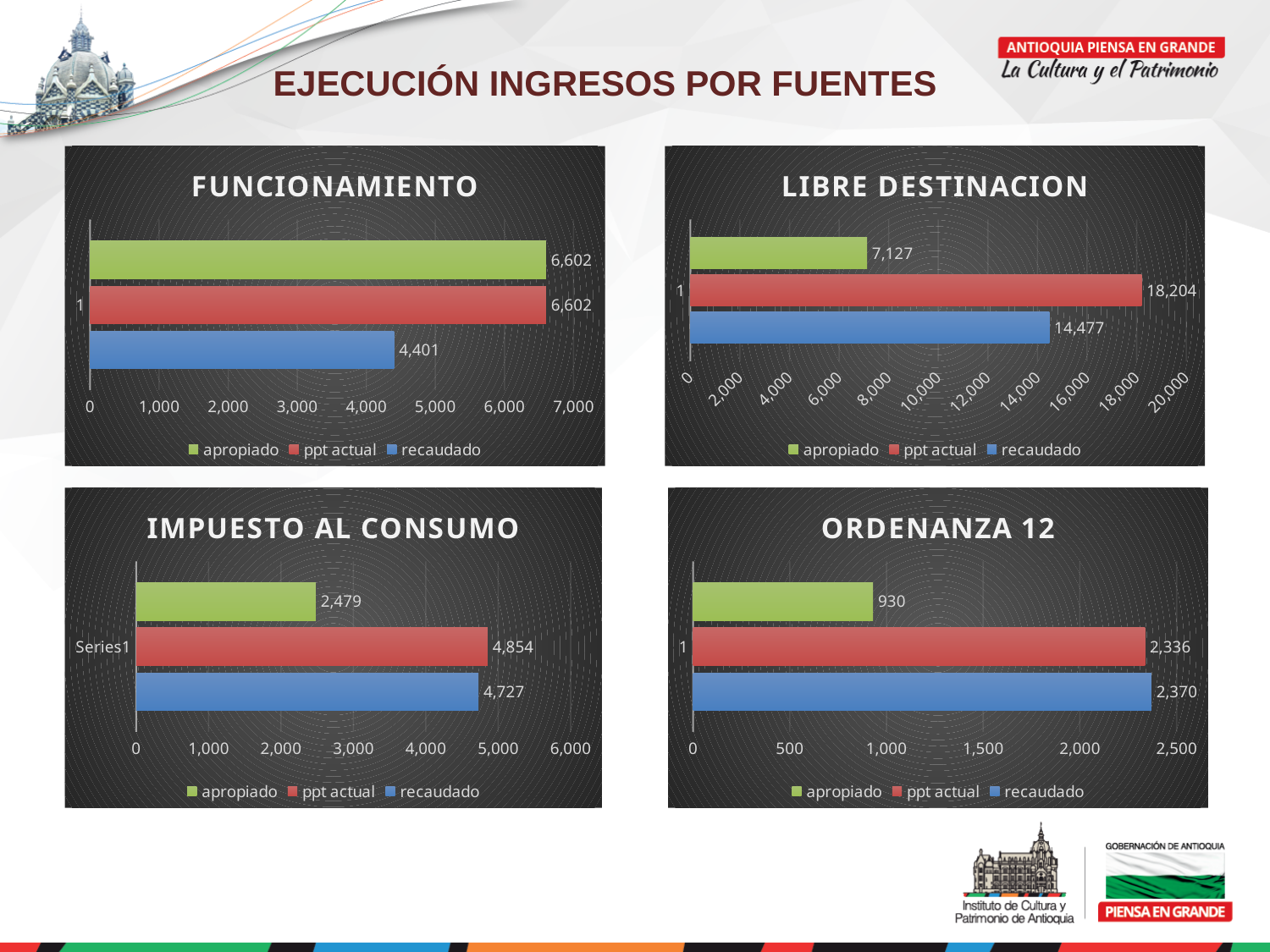
In the IMPUESTO AL CONSUMO chart, which series has the highest value? ppt actual In the ORDENANZA 12 chart, is the value for apropiado greater or less than 1,000? less In the LIBRE DESTINACION chart, which series has the lowest value? apropiado How many series does the legend of the ORDENANZA 12 chart list? 3 In the FUNCIONAMIENTO chart, what is the value for apropiado? 6,602 What kind of chart is the LIBRE DESTINACION chart? bar chart In the IMPUESTO AL CONSUMO chart, what is the value for apropiado? 2,479 In the ORDENANZA 12 chart, what is the value for recaudado? 2,370 In the FUNCIONAMIENTO chart, what is the difference between apropiado and recaudado? 2,201 In the FUNCIONAMIENTO chart, what is the value for recaudado? 4,401 In the LIBRE DESTINACION chart, what is the difference between ppt actual and recaudado? 3,727 In the LIBRE DESTINACION chart, what is the value for ppt actual? 18,204